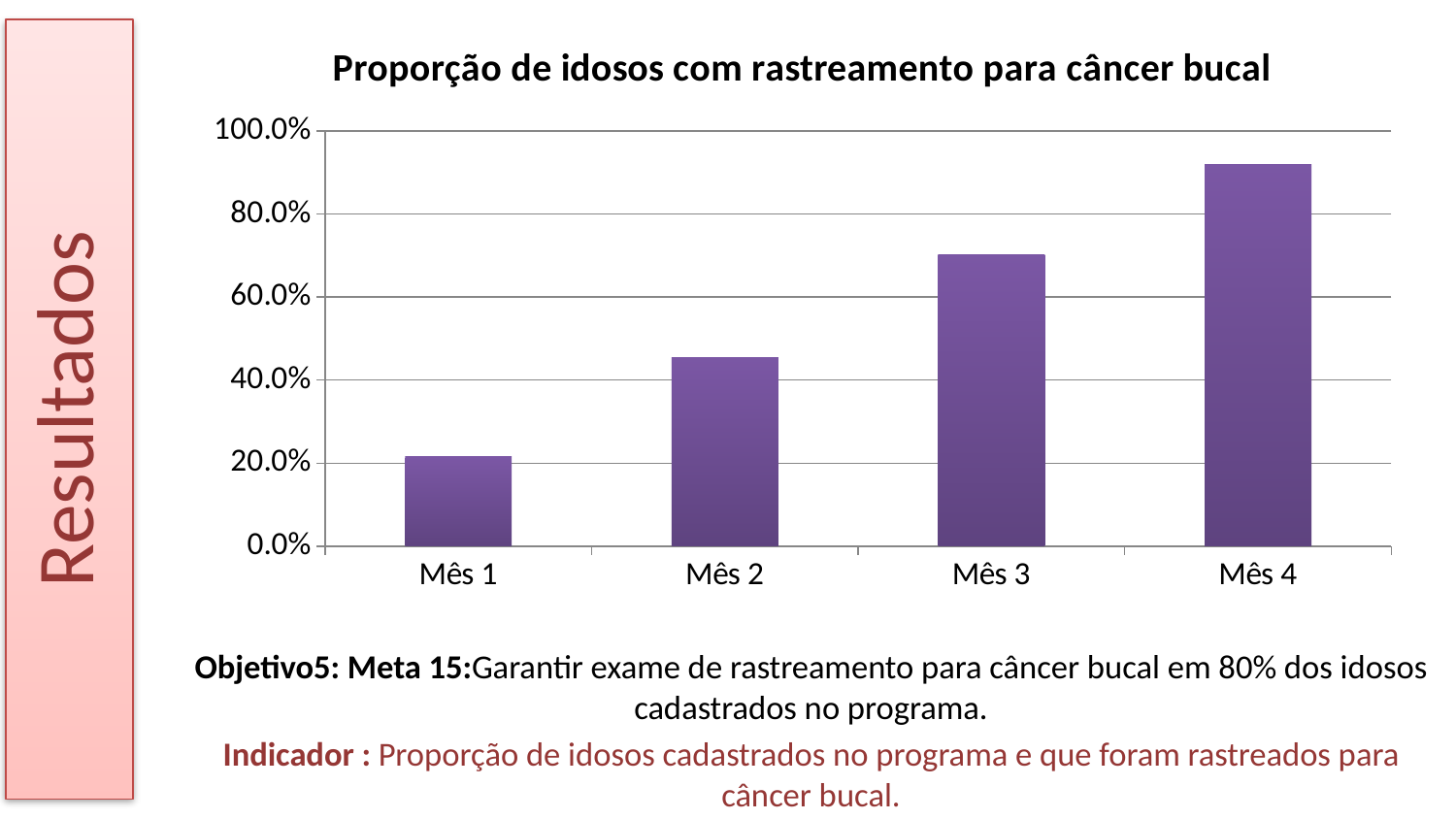
Is the value for Mês 3 greater or less than 80.0%? less Is the value for Mês 3 greater or less than 60.0%? greater Is the value for Mês 4 greater or less than 80.0%? greater What type of chart is shown on the slide? bar chart Do the values rise or fall from Mês 1 to Mês 4? rise What is the title of the chart? Proporção de idosos com rastreamento para câncer bucal Which month has the lowest proportion? Mês 1 How many categories (months) are plotted on the chart? 4 Which is larger, the value for Mês 2 or the value for Mês 3? Mês 3 Which month has the highest proportion? Mês 4